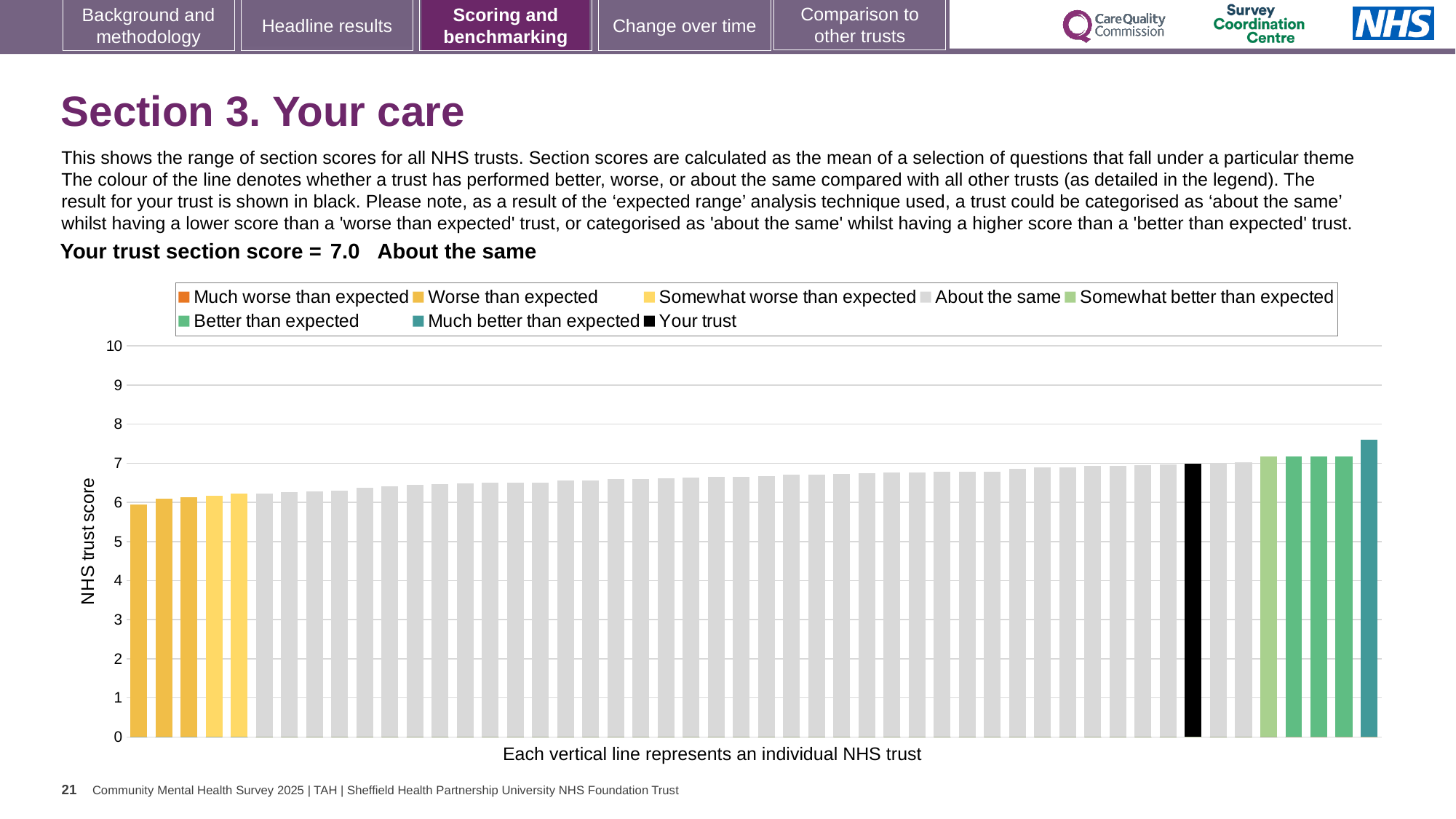
Is the value for your trust greater or less than 5? greater What is the label on the vertical axis? NHS trust score Is the value of the lowest bar greater or less than 7? less How many entries does the chart legend list? 8 Is the value of the highest bar greater or less than 7? greater Which legend category does the highest bar belong to? Much better than expected Do the bar values rise or fall from left to right along the x axis? rise Which category is your trust's section score placed in? About the same What is your trust's section score for Section 3. Your care? 7.0 What colour is the bar representing your trust? black What kind of chart is shown on the slide? bar chart